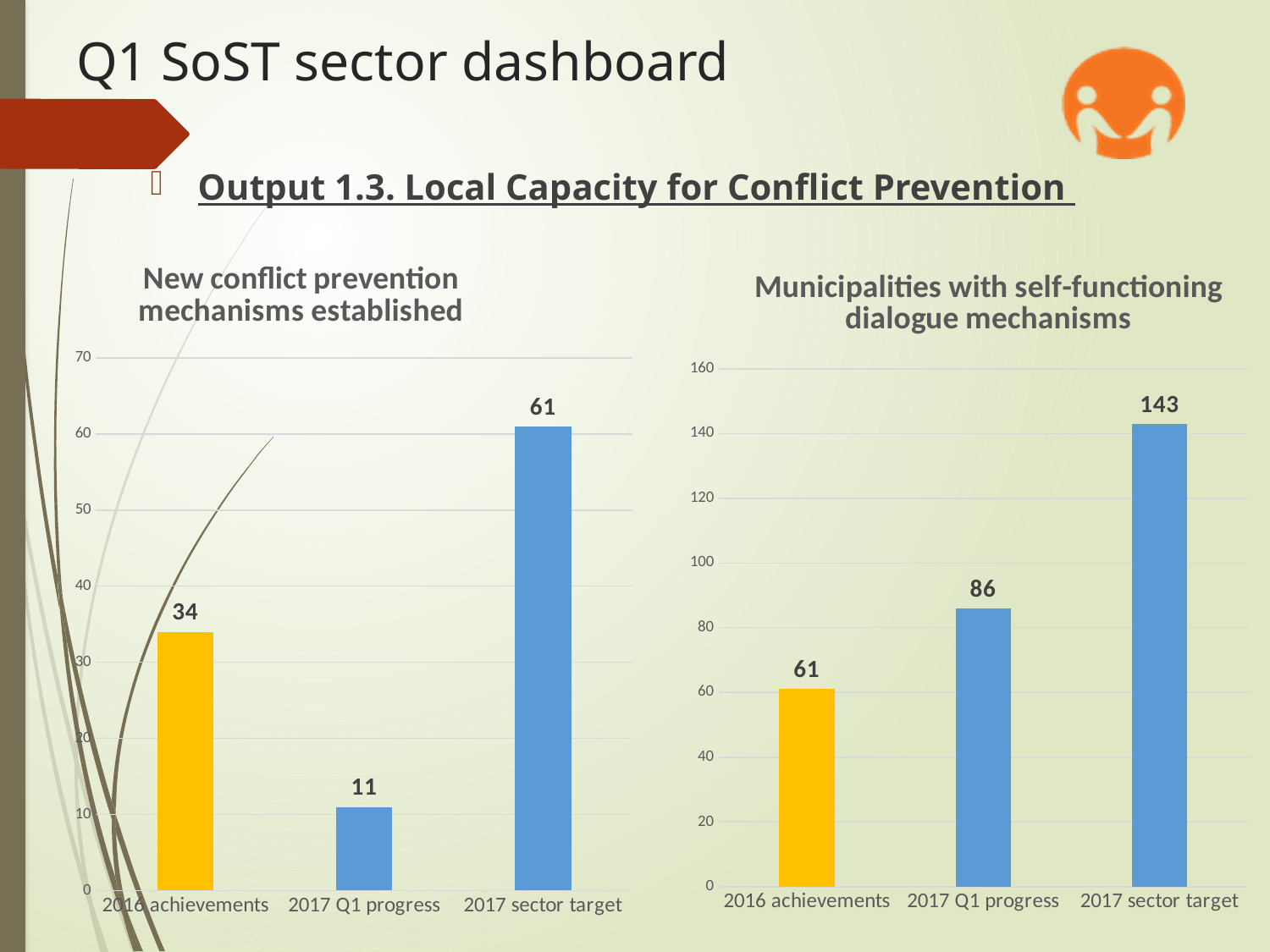
In the 'New conflict prevention mechanisms established' chart, which category has the lowest value? 2017 Q1 progress In the 'Municipalities with self-functioning dialogue mechanisms' chart, what is the value for 2017 sector target? 143 In the 'Municipalities with self-functioning dialogue mechanisms' chart, what is the difference between 2017 Q1 progress and 2016 achievements? 25 In the 'Municipalities with self-functioning dialogue mechanisms' chart, do the values rise or fall from left to right along the x axis? rise In the 'New conflict prevention mechanisms established' chart, what is the value for 2016 achievements? 34 In the 'Municipalities with self-functioning dialogue mechanisms' chart, which category has the lowest value? 2016 achievements In the 'New conflict prevention mechanisms established' chart, what is the difference between the 2017 sector target and the 2016 achievements? 27 In the 'New conflict prevention mechanisms established' chart, what is the value for 2017 Q1 progress? 11 In the 'Municipalities with self-functioning dialogue mechanisms' chart, what is the value for 2017 Q1 progress? 86 How many categories are shown in the 'New conflict prevention mechanisms established' chart? 3 In the 'New conflict prevention mechanisms established' chart, which category has the highest value? 2017 sector target What kind of chart is the 'Municipalities with self-functioning dialogue mechanisms' chart? bar chart